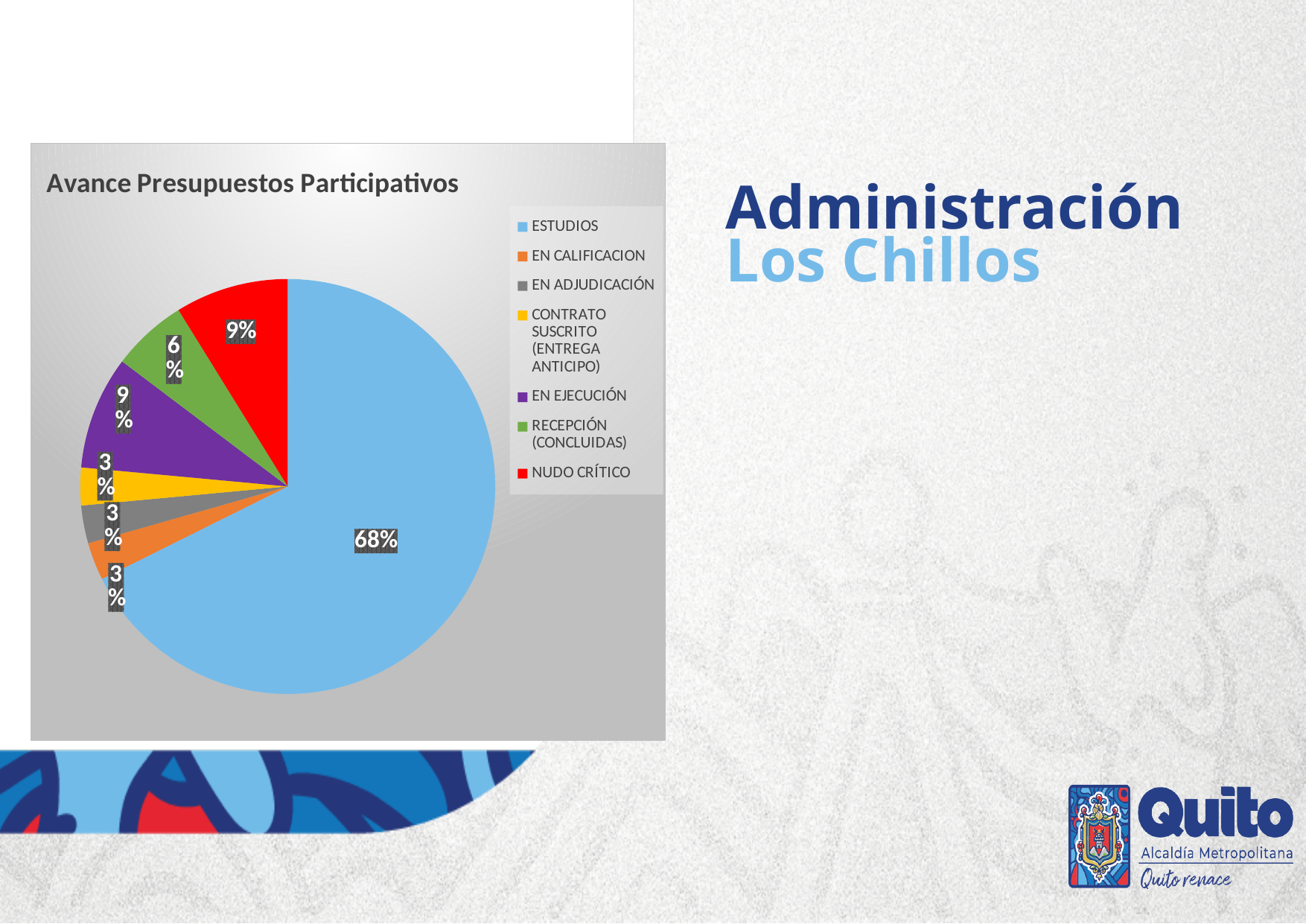
What is the difference between the ESTUDIOS share and the NUDO CRÍTICO share? 59% Which category has the largest slice of the pie? ESTUDIOS What type of chart is shown on the slide? pie chart What share of the pie does NUDO CRÍTICO represent? 9% What share of the pie does EN CALIFICACION represent? 3% Which is larger, the share for EN EJECUCIÓN or the share for RECEPCIÓN (CONCLUIDAS)? EN EJECUCIÓN What share of the pie does RECEPCIÓN (CONCLUIDAS) represent? 6% How many categories does the legend list? 7 What colour is the slice for NUDO CRÍTICO? red What is the title of the chart? Avance Presupuestos Participativos